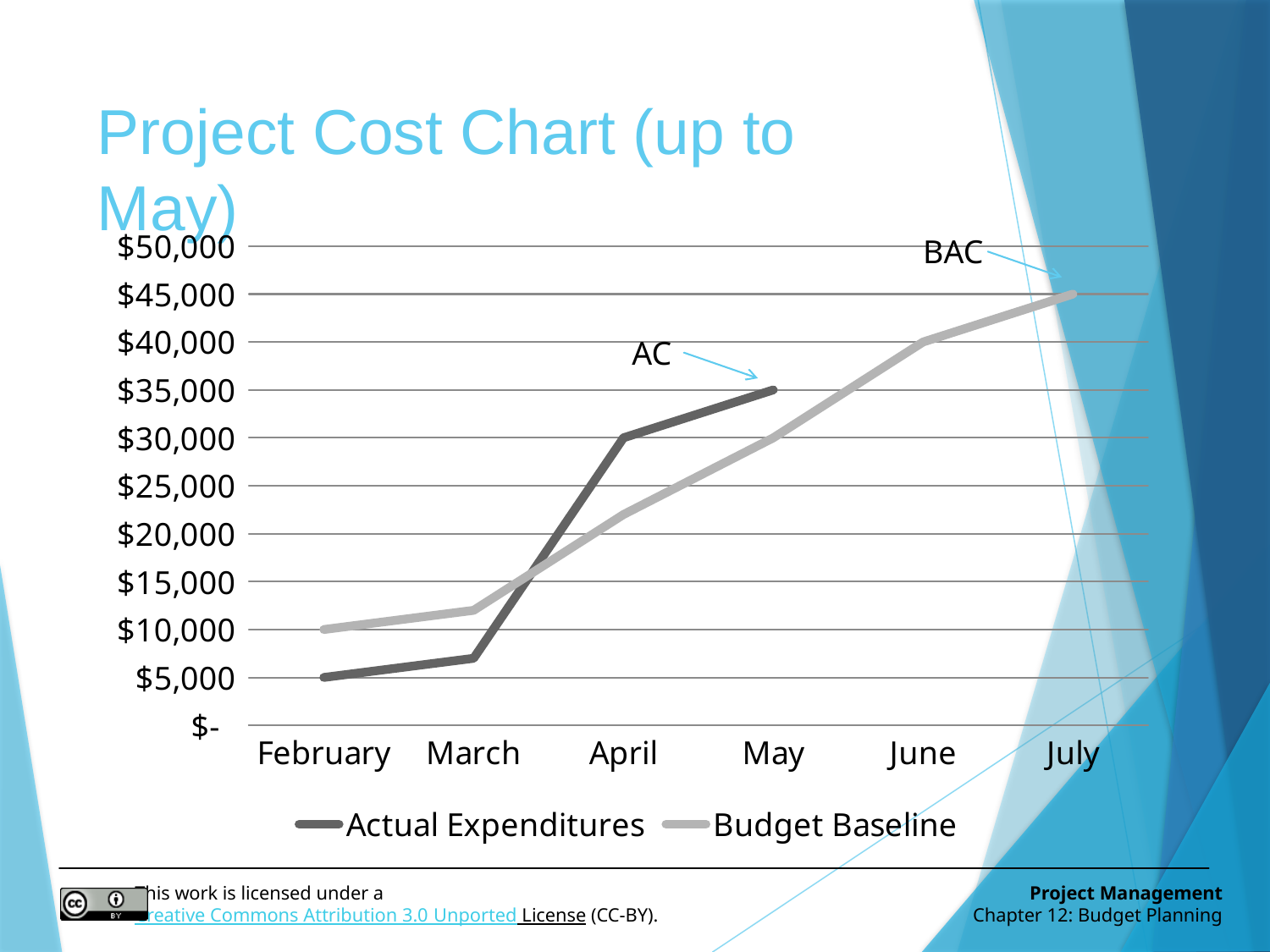
What is the Budget Baseline value for July? $45,000 Is the Actual Expenditures value for March greater or less than $10,000? less In April, which series has the larger value, Actual Expenditures or Budget Baseline? Actual Expenditures What label is attached by an arrow to the end of the Budget Baseline line in July? BAC In which month does the Budget Baseline reach its highest value? July What is the Actual Expenditures value for February? $5,000 Is the Budget Baseline value for April greater or less than $20,000? greater Do the Budget Baseline values rise or fall from February to July? Rise What is the Actual Expenditures value for May? $35,000 How many months are shown on the x axis? 6 How many series does the legend list? 2 What kind of chart is shown on the slide? Line chart